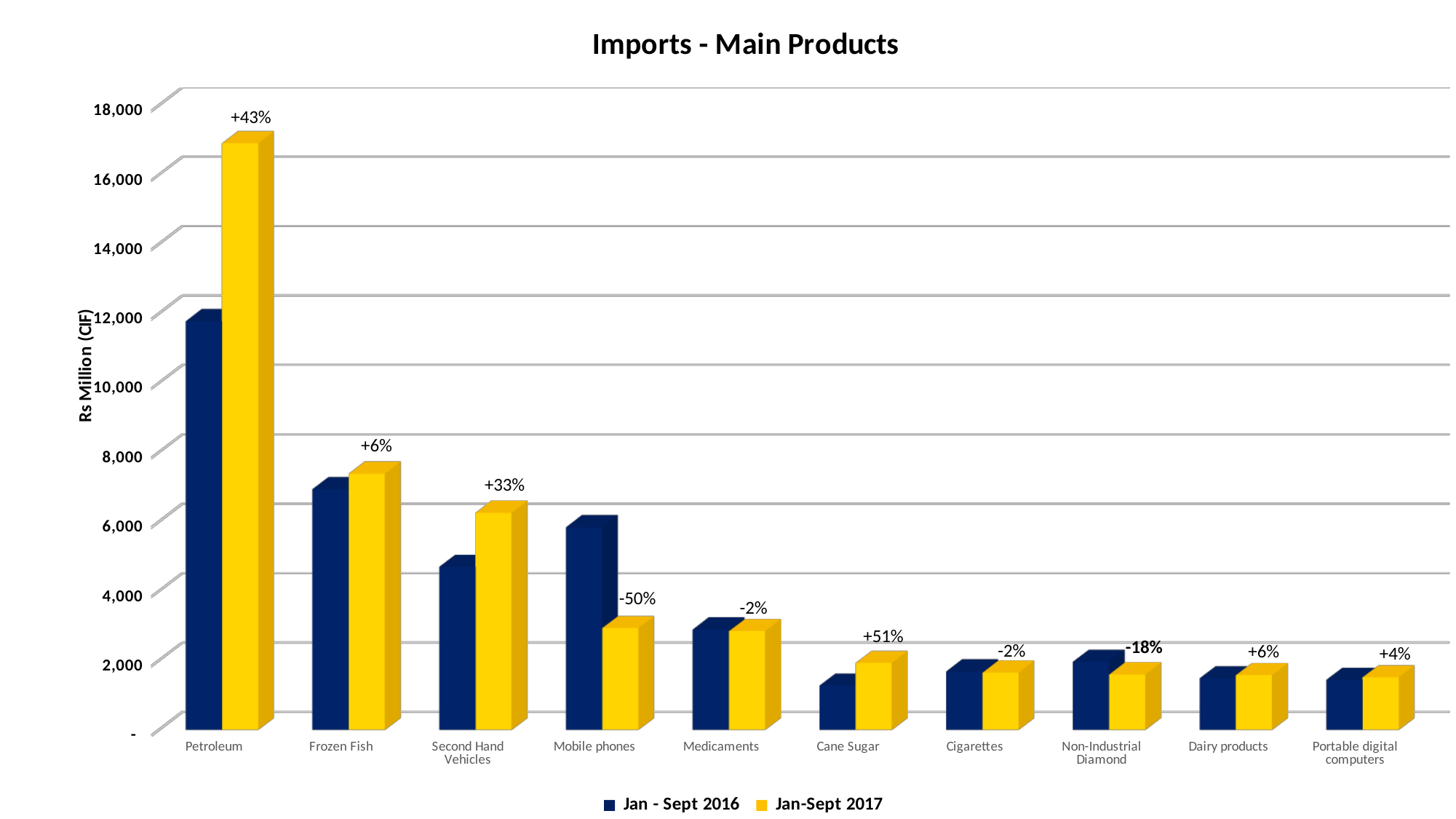
What type of chart is shown on the slide? Bar chart What percentage change is labelled for Non-Industrial Diamond? -18% How many product categories are shown on the x axis? 10 Is the Jan - Sept 2016 value for Mobile phones greater or less than 4,000? greater What percentage change is labelled for Mobile phones? -50% How many series does the legend list? 2 Is the Jan-Sept 2017 value for Petroleum greater or less than 16,000? greater What percentage change is labelled above the Petroleum bars? +43% What is the title of the chart? Imports - Main Products Which product has the highest Jan-Sept 2017 import value? Petroleum For Mobile phones, which is larger: the Jan - Sept 2016 value or the Jan-Sept 2017 value? Jan - Sept 2016 Which product shows the largest percentage increase label? Cane Sugar